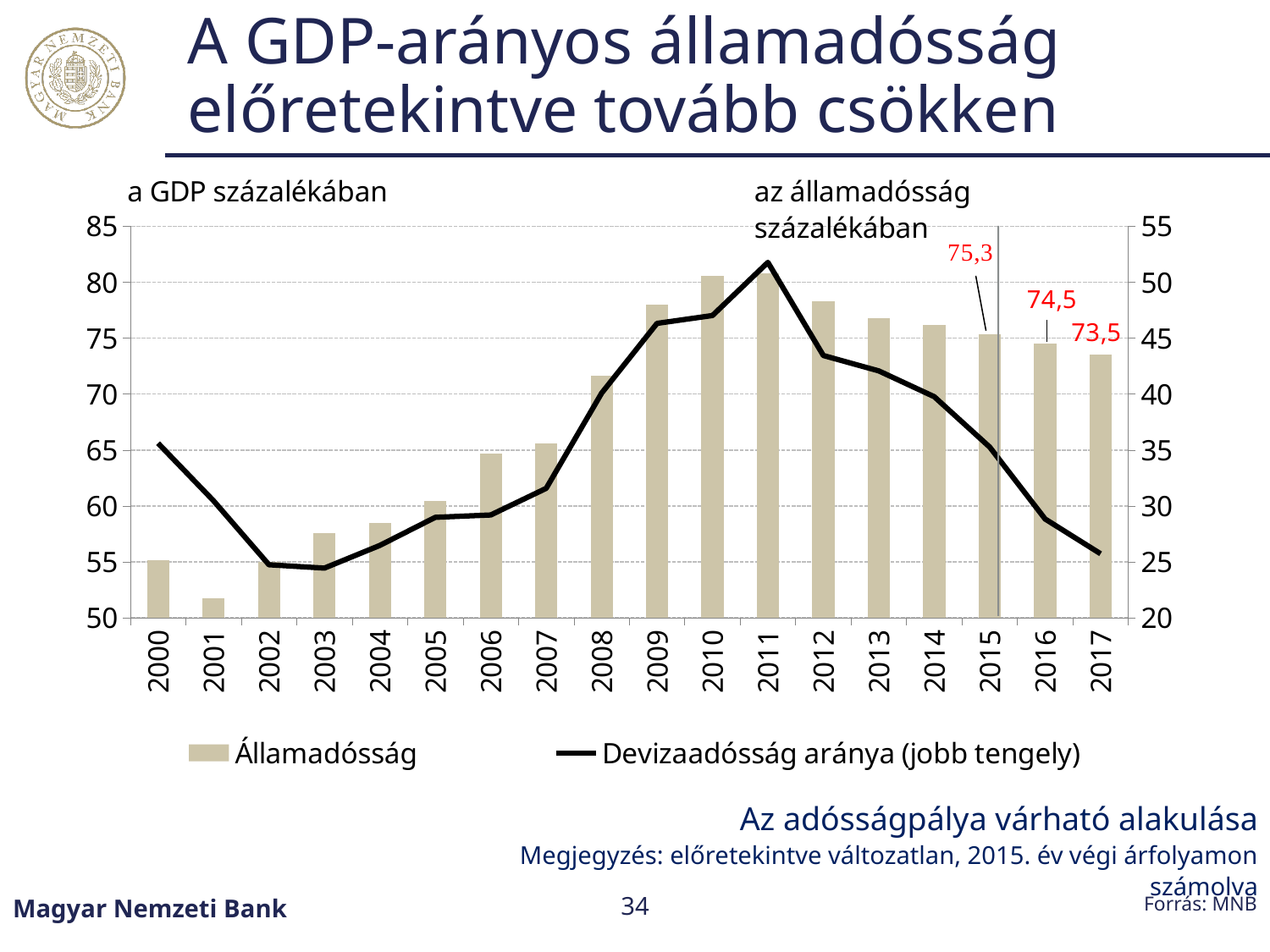
What is the value of the Államadósság bar for 2016? 74,5 Which year has the lowest Államadósság bar? 2001 Is the Devizaadósság aránya value for 2012 (right axis) greater or less than 40? greater Is the Államadósság value for 2008 greater or less than 70? greater How many years are shown on the x axis? 18 By how much does the Államadósság value fall from 2015 to 2017? 1,8 What is the value of the Államadósság bar for 2015? 75,3 Do the Államadósság bars rise or fall from 2015 to 2017? fall What is the value of the Államadósság bar for 2017? 73,5 In which year does the Devizaadósság aránya line reach its highest point? 2011 Which year has the larger Államadósság bar, 2012 or 2013? 2012 How many series does the legend list? 2